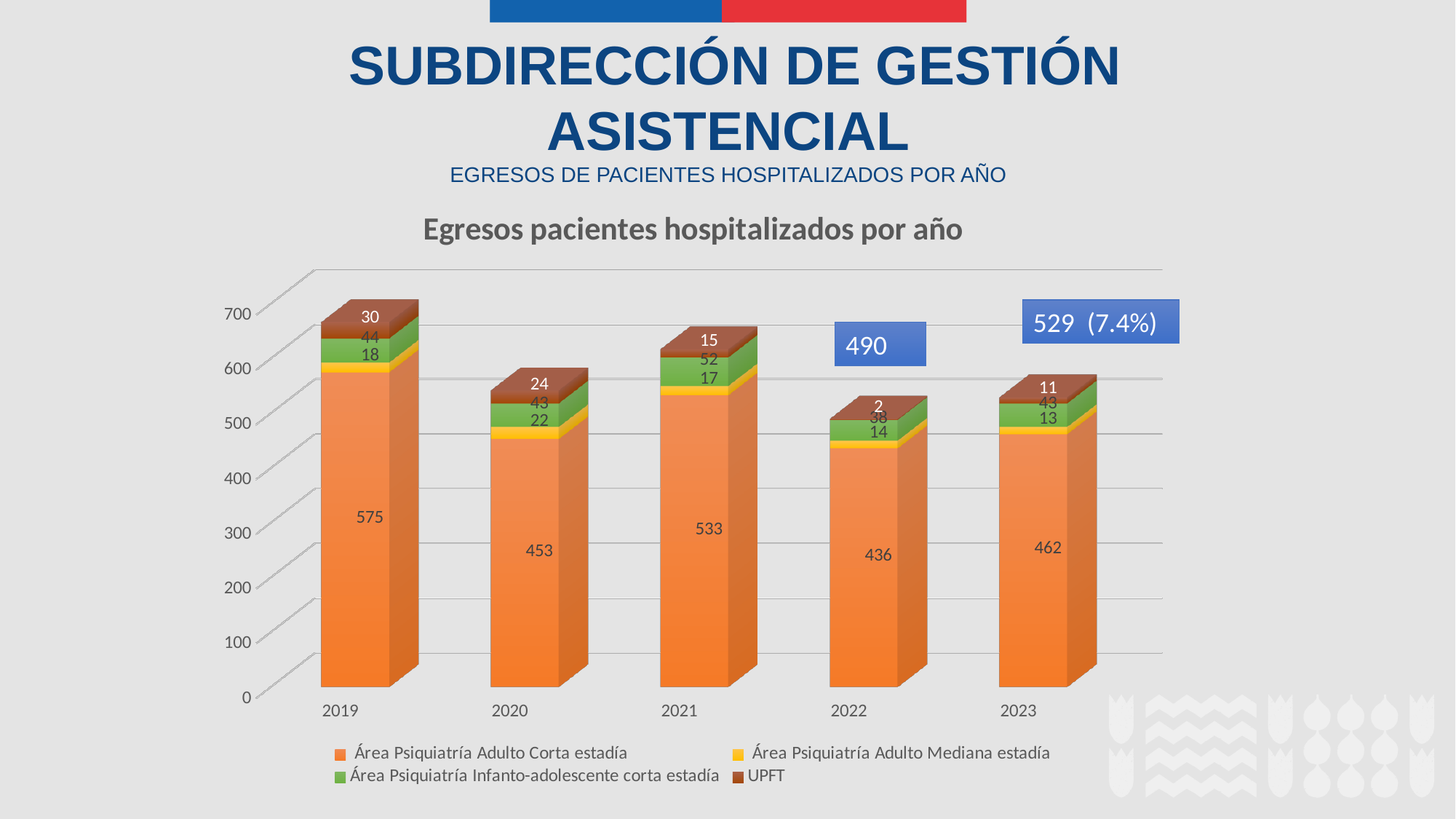
What is the value for Área Psiquiatría Infanto-adolescente corta estadía in 2021? 52 Which is larger, the UPFT value for 2019 or for 2020? 2019 What is the total of the stacked bar for 2022? 490 How many series does the legend list? 4 Which year has the highest value for Área Psiquiatría Adulto Corta estadía? 2019 What is the UPFT value for 2022? 2 How many years are shown on the x axis? 5 What is the total of the stacked bar for 2019? 667 What type of chart is shown on the slide? Stacked bar chart What is the difference between the Área Psiquiatría Adulto Corta estadía values for 2021 and 2020? 80 What is the value for Área Psiquiatría Adulto Corta estadía in 2019? 575 Which year has the lowest UPFT value? 2022